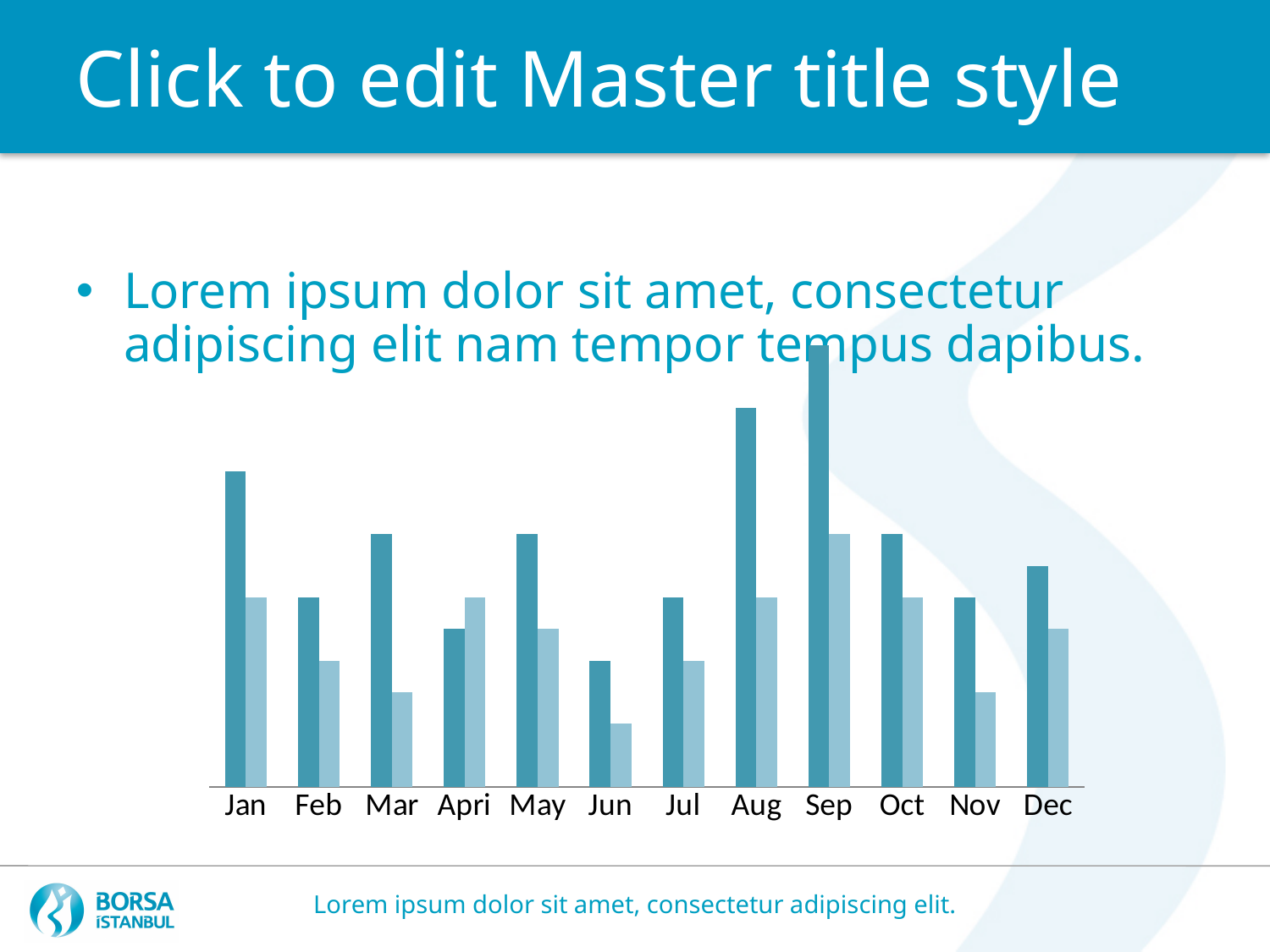
Which month has the tallest dark blue bar in the chart? Sep Which month has the taller light blue bar, Sep or Oct? Sep For Apri, which bar is taller, the dark blue one or the light blue one? The light blue one Which month has the shortest light blue bar in the chart? Jun Which month has the tallest light blue bar in the chart? Sep How many months are shown on the x axis of the chart? 12 Which month has the shortest dark blue bar in the chart? Jun Which month has the taller dark blue bar, Aug or Oct? Aug What kind of chart is shown on the slide? Bar chart Does the chart display a legend? No How many bars are plotted for each month in the chart? 2